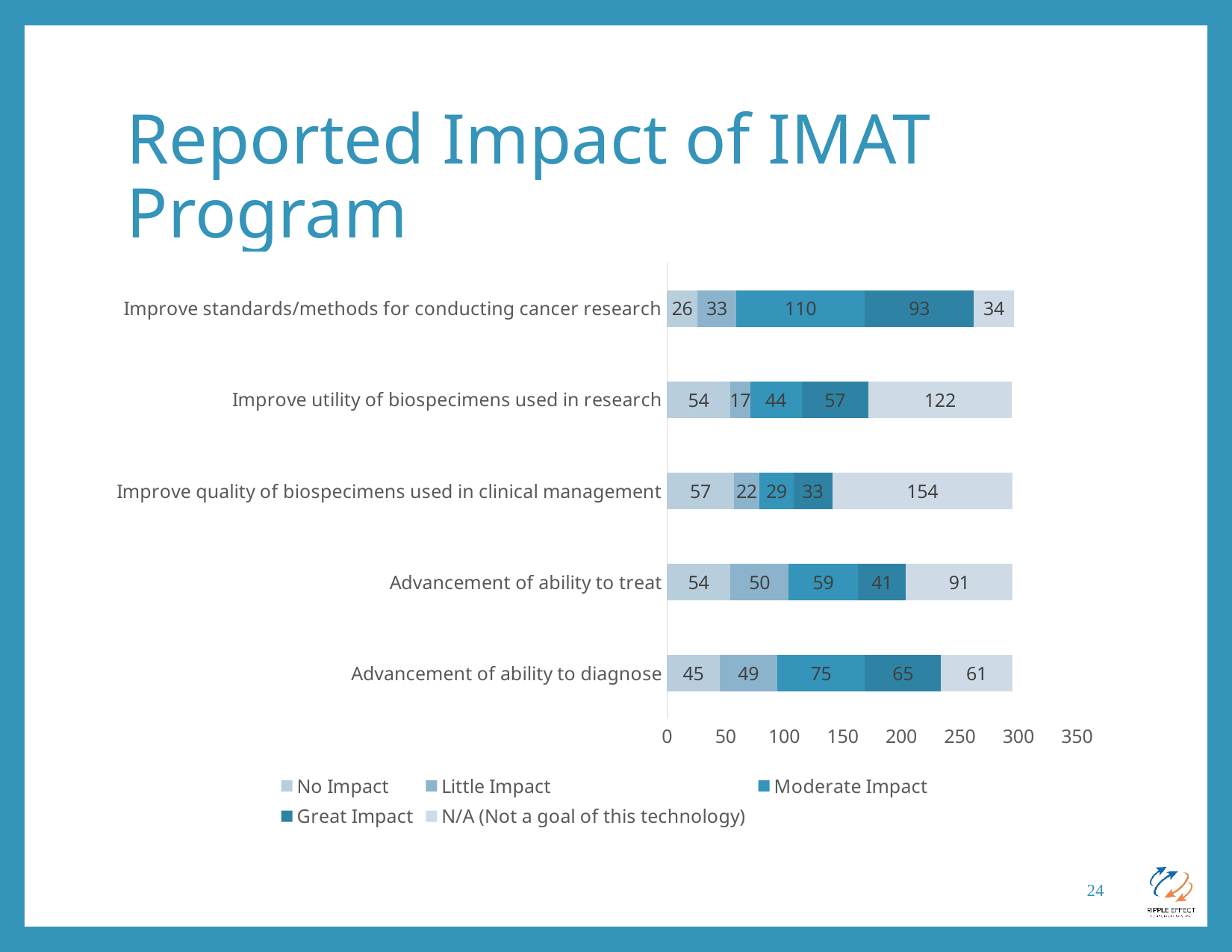
What is the total of the stacked bar for 'Advancement of ability to diagnose'? 295 How many series does the legend list? 5 What is the difference between the Moderate Impact values for 'Advancement of ability to diagnose' and 'Advancement of ability to treat'? 16 What is the Moderate Impact value for 'Improve standards/methods for conducting cancer research'? 110 What type of chart is shown on the slide? Stacked bar chart Which category has the lowest Little Impact value? Improve utility of biospecimens used in research What is the title of the chart on the slide? Reported Impact of IMAT Program What is the N/A (Not a goal of this technology) value for 'Improve quality of biospecimens used in clinical management'? 154 Which is larger: the N/A value for 'Improve utility of biospecimens used in research' or the N/A value for 'Advancement of ability to treat'? Improve utility of biospecimens used in research Which category has the highest Great Impact value? Improve standards/methods for conducting cancer research How many categories are plotted on the chart? 5 What is the Great Impact value for 'Advancement of ability to treat'? 41